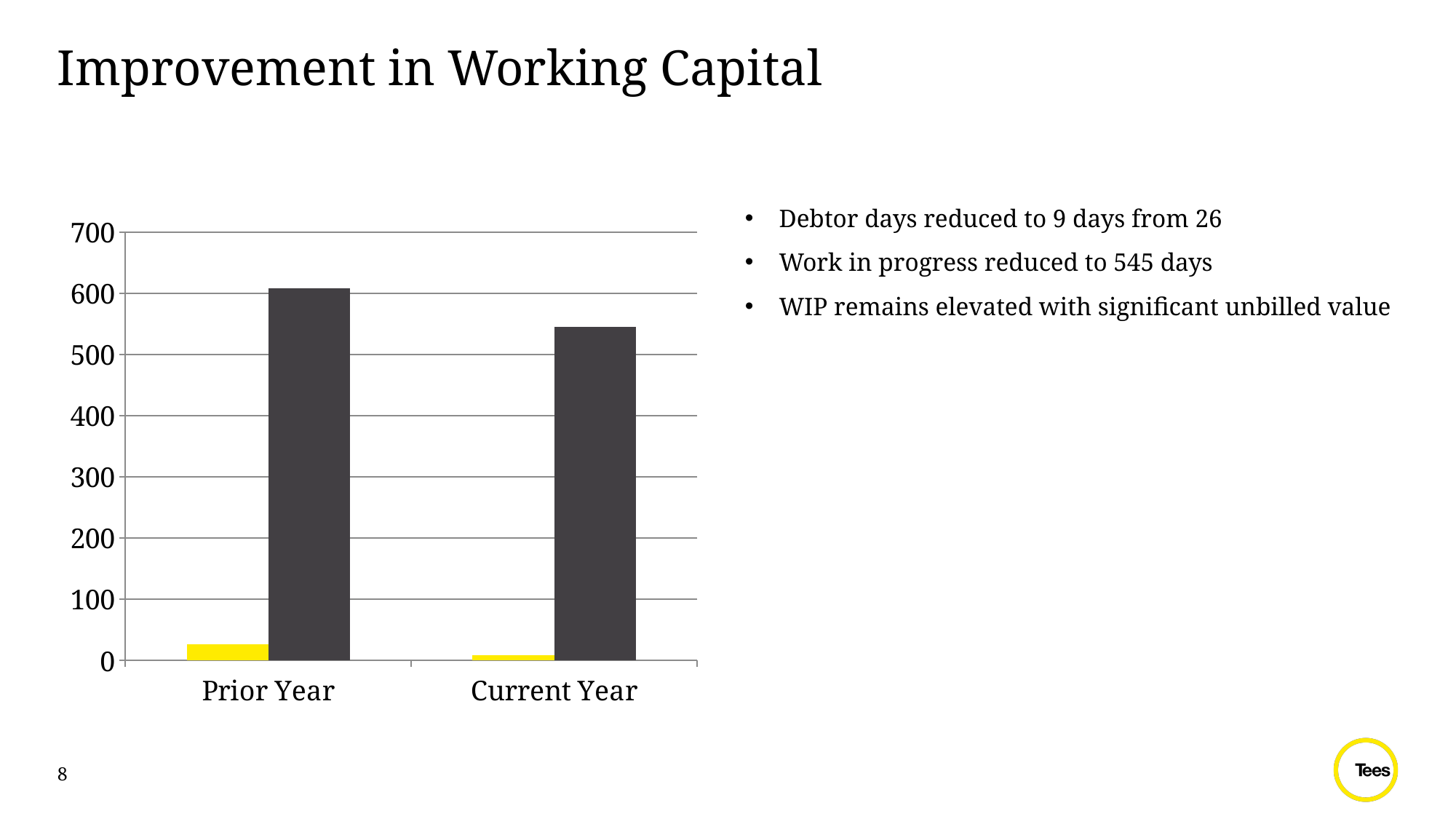
Is the value of the dark grey bar for Prior Year greater or less than 500? greater Is the value of the dark grey bar for Current Year greater or less than 500? greater What is the highest value shown on the chart's vertical axis? 700 How many categories are shown on the x axis of the chart? 2 What is the title of the slide containing the chart? Improvement in Working Capital What kind of chart is shown on the slide? bar chart Is the value of the yellow bar for Prior Year greater or less than 100? less Which category has the highest dark grey bar? Prior Year Do the dark grey bars rise or fall from Prior Year to Current Year? fall Which category has the taller dark grey bar, Prior Year or Current Year? Prior Year Which category has the taller yellow bar, Prior Year or Current Year? Prior Year